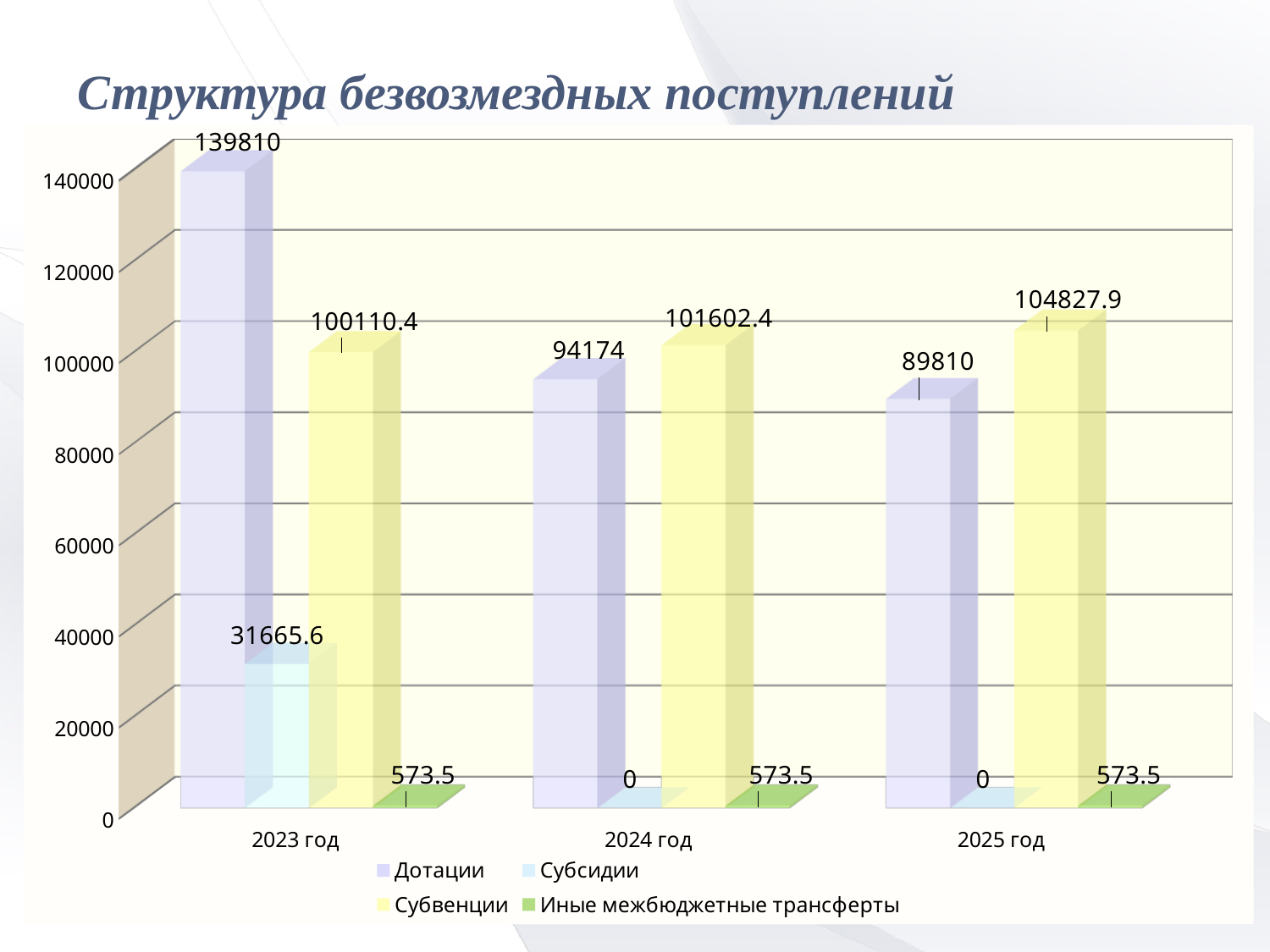
What is the value of Субсидии for 2024 год? 0 What is the value of Субвенции for 2025 год? 104827.9 In which year is the value of Дотации the highest? 2023 год What is the value of Дотации for 2023 год? 139810 Do the values of Дотации rise or fall from 2023 год to 2025 год? Fall How many series does the legend list? 4 In which year is the value of Дотации the lowest? 2025 год What type of chart is shown on the slide? Bar chart Which is larger in 2024 год: Дотации or Субвенции? Субвенции What is the value of Иные межбюджетные трансферты for 2023 год? 573.5 What is the difference between Дотации in 2023 год and 2024 год? 45636 How many year categories are shown on the x axis? 3